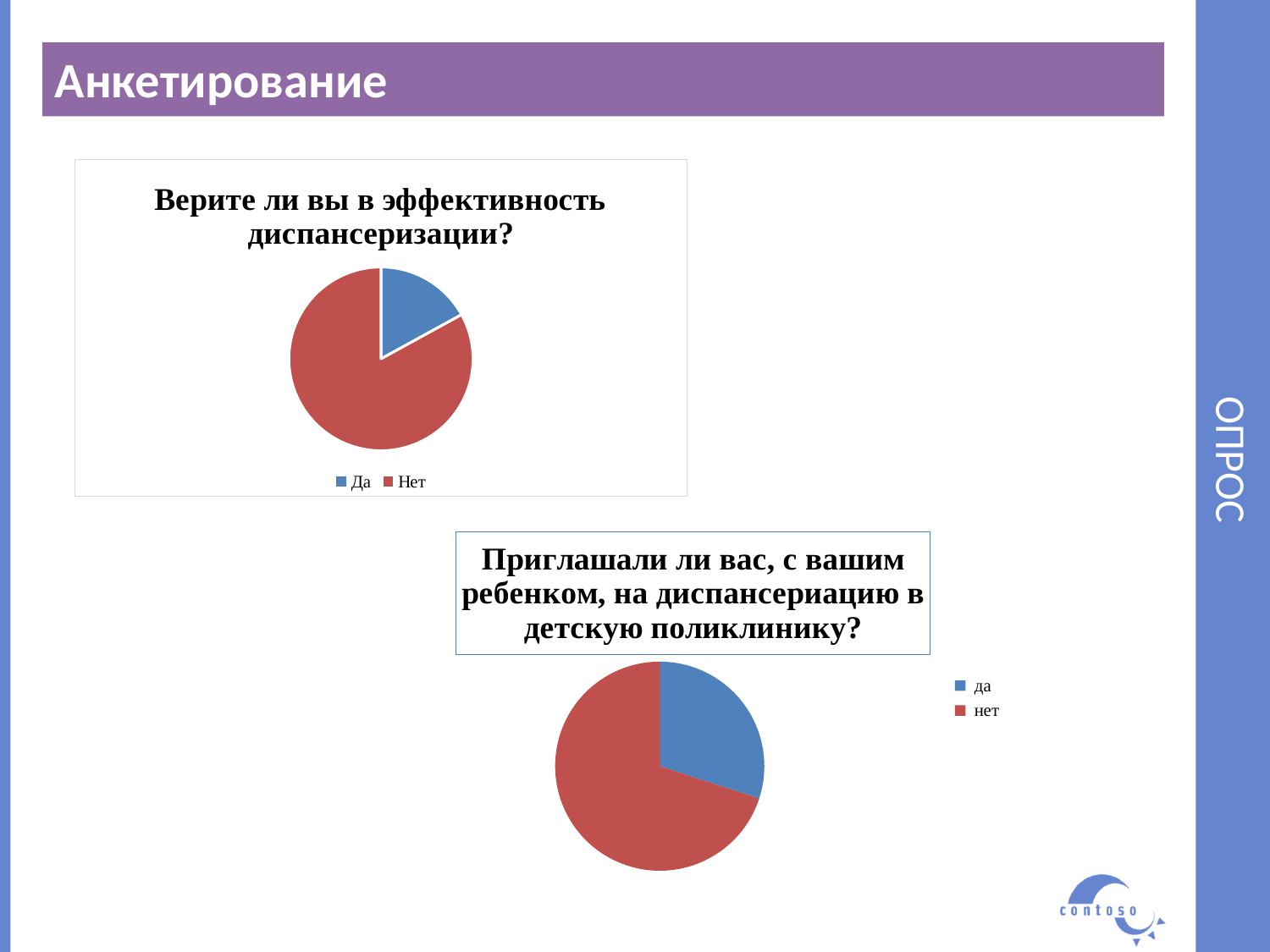
In the chart titled "Верите ли вы в эффективность диспансеризации?", which category has the largest slice? Нет What kind of chart is the chart titled "Приглашали ли вас, с вашим ребенком, на диспансериацию в детскую поликлинику?"? pie chart In the chart titled "Верите ли вы в эффективность диспансеризации?", what colour is the Да slice? blue What is the title of the upper-left pie chart on the slide? Верите ли вы в эффективность диспансеризации? In the chart titled "Приглашали ли вас, с вашим ребенком, на диспансериацию в детскую поликлинику?", which category has the smallest slice? да In the chart titled "Приглашали ли вас, с вашим ребенком, на диспансериацию в детскую поликлинику?", which slice is larger, да or нет? нет In the chart titled "Верите ли вы в эффективность диспансеризации?", which category has the smallest slice? Да How many slices does the chart titled "Верите ли вы в эффективность диспансеризации?" have? 2 How many entries does the legend of the chart titled "Приглашали ли вас, с вашим ребенком, на диспансериацию в детскую поликлинику?" list? 2 In the chart titled "Приглашали ли вас, с вашим ребенком, на диспансериацию в детскую поликлинику?", which category has the largest slice? нет In the chart titled "Верите ли вы в эффективность диспансеризации?", which slice is larger, Да or Нет? Нет What kind of chart is the chart titled "Верите ли вы в эффективность диспансеризации?"? pie chart